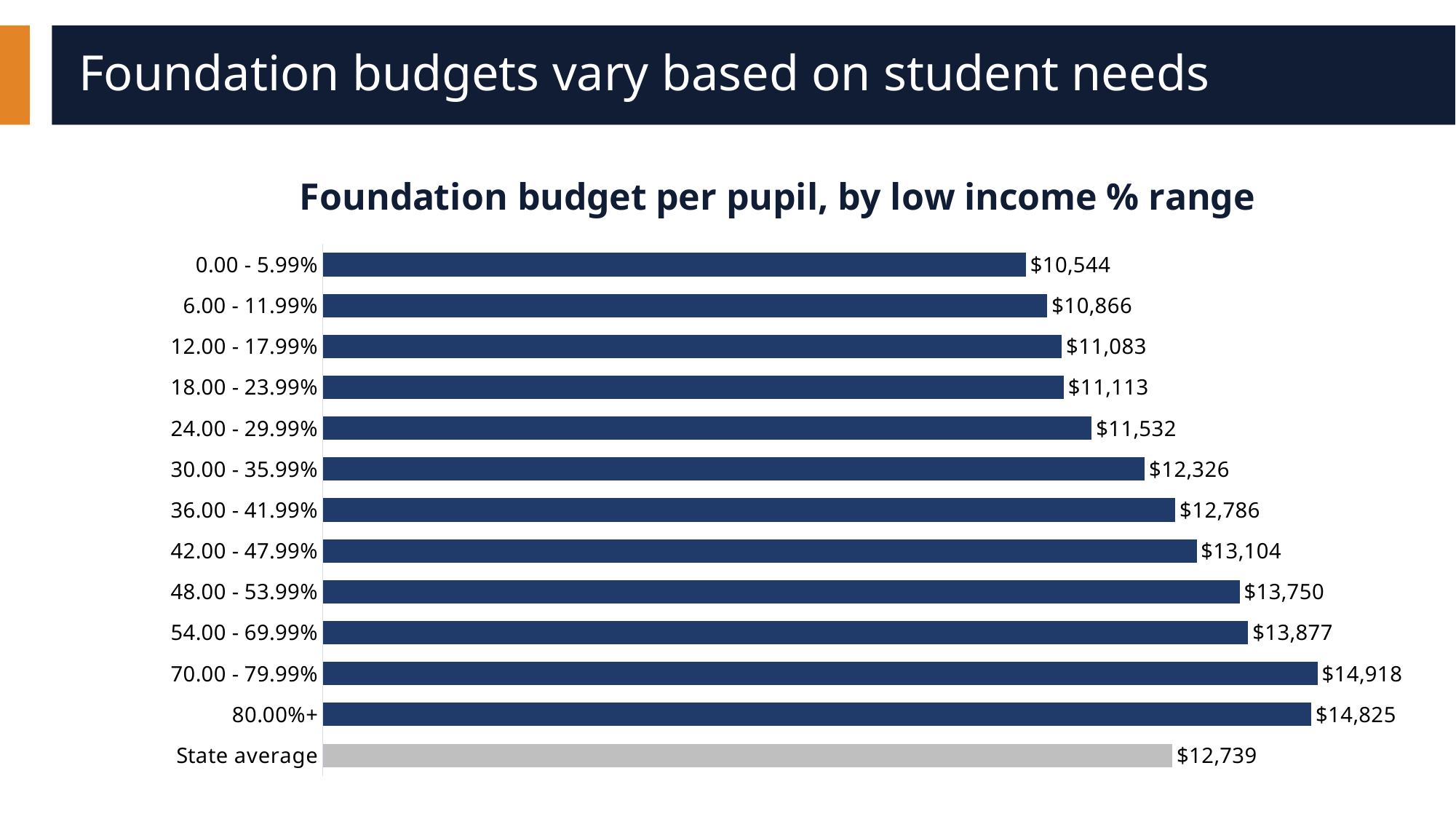
What is the foundation budget per pupil for the 0.00 - 5.99% low income range? $10,544 Which is larger: the foundation budget per pupil for the 36.00 - 41.99% range or the State average? 36.00 - 41.99% Which low income % range has the highest foundation budget per pupil? 70.00 - 79.99% How many bars are shown in the chart, including the State average? 13 Do the foundation budgets per pupil generally rise or fall as the low income % range increases from 0.00 - 5.99% to 70.00 - 79.99%? Rise What is the foundation budget per pupil for the 48.00 - 53.99% low income range? $13,750 What kind of chart is shown on the slide? Bar chart Which low income % range has the lowest foundation budget per pupil? 0.00 - 5.99% What is the difference between the foundation budget per pupil for the 70.00 - 79.99% range and the 80.00%+ range? $93 What is the State average foundation budget per pupil? $12,739 How much higher is the foundation budget per pupil for the 30.00 - 35.99% range than for the 24.00 - 29.99% range? $794 What is the title of the chart? Foundation budget per pupil, by low income % range